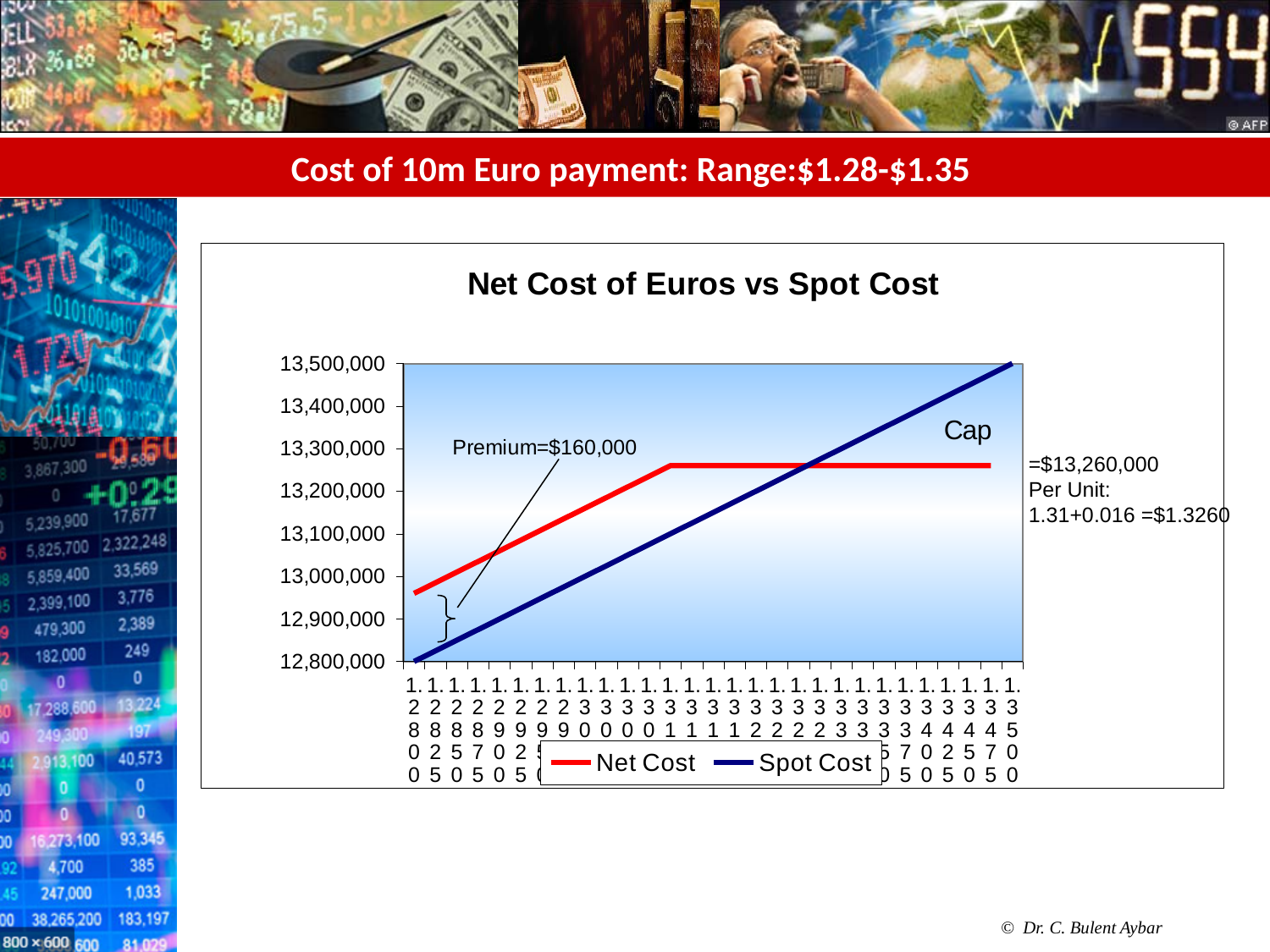
At the rightmost exchange rate (1.3500), which is higher, Net Cost or Spot Cost? Spot Cost What is the cap value of the Net Cost shown on the chart? $13,260,000 What is the per-unit cap value given next to the chart? $1.3260 What kind of chart is shown on the slide? line chart At the leftmost exchange rate (1.2800), which is higher, Net Cost or Spot Cost? Net Cost Does the Spot Cost line rise or fall as the exchange rate increases along the x axis? rises Is the Net Cost at the rightmost exchange rate (1.3500) greater or less than 13,300,000? less What premium amount is annotated on the chart? $160,000 How many series does the chart legend list? 2 Is the Spot Cost at the rightmost exchange rate (1.3500) greater or less than 13,400,000? greater What is the title of the chart? Net Cost of Euros vs Spot Cost Which series is drawn in red? Net Cost